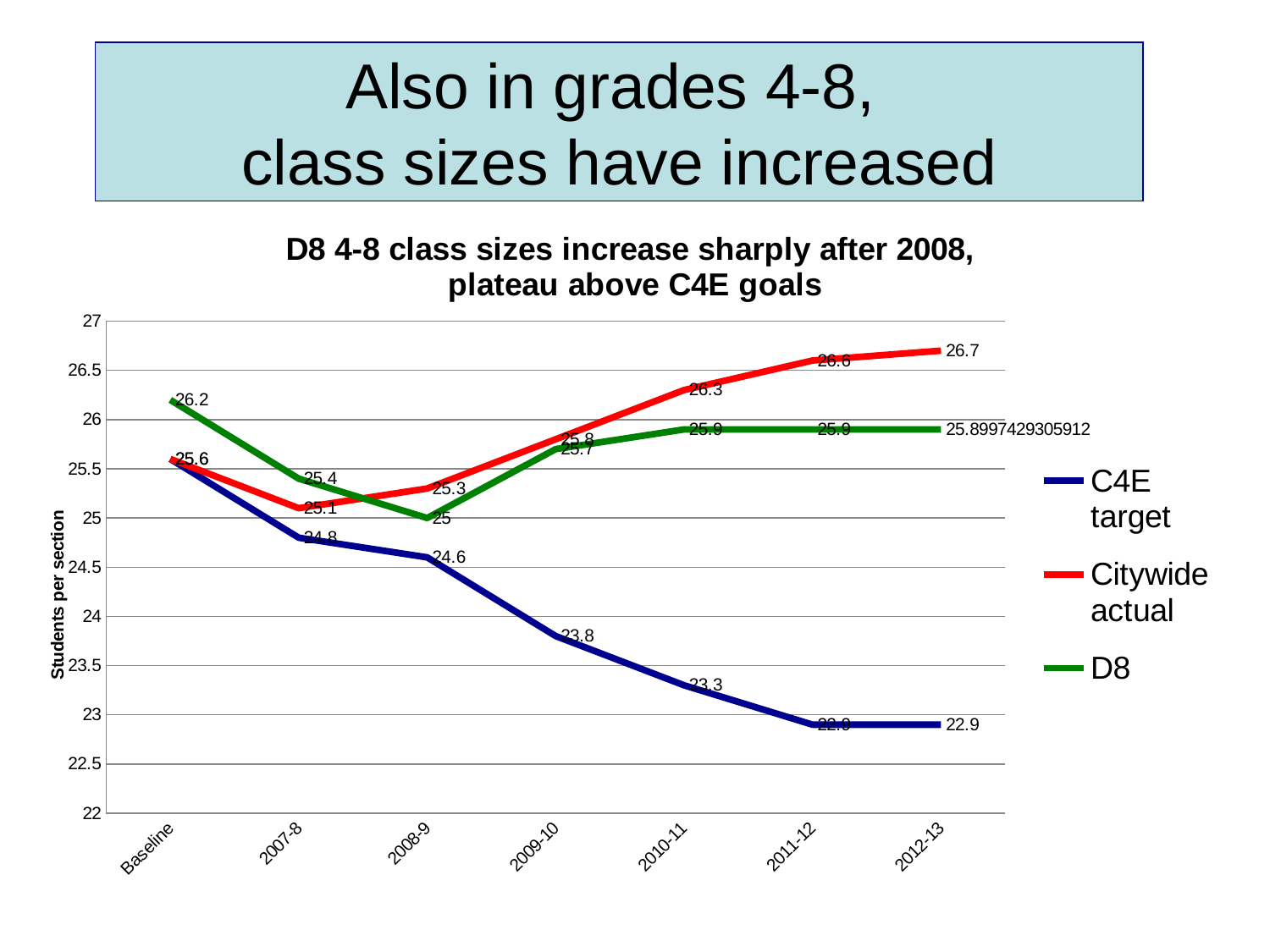
How many series does the legend list? 3 In which year is the D8 value lowest? 2008-9 How many points are plotted along the x axis for each series? 7 What is the C4E target value for 2011-12? 22.9 What is the D8 value for 2008-9? 25 What is the D8 value at Baseline? 26.2 What is the Citywide actual value for 2012-13? 26.7 What is the Citywide actual value for 2007-8? 25.1 What is the difference between the Citywide actual and C4E target values in 2012-13? 3.8 What kind of chart is shown on the slide? line chart In 2010-11, which is larger: Citywide actual or D8? Citywide actual In which year is the Citywide actual value highest? 2012-13